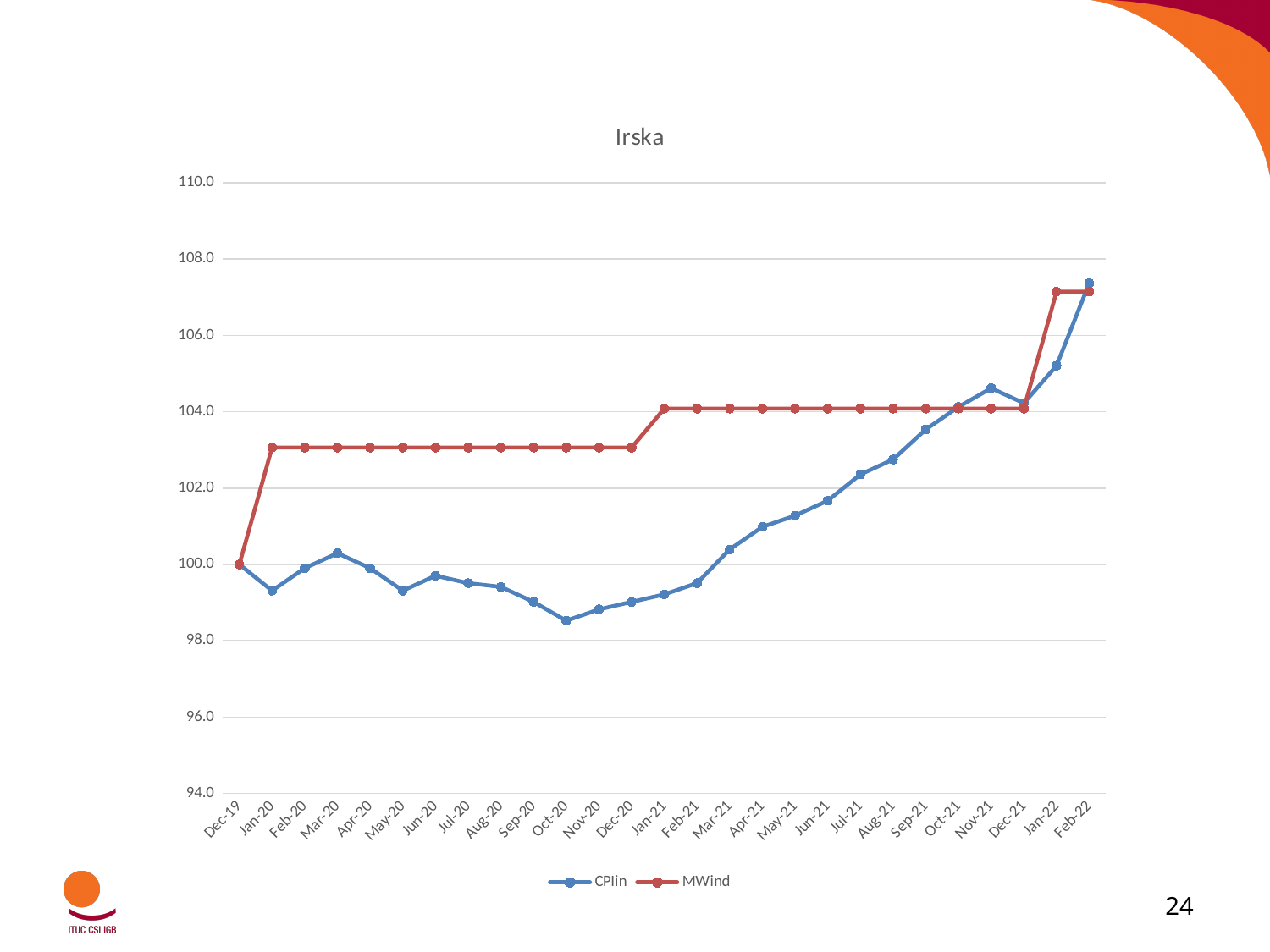
Is the value for CPlin in Aug-21 greater or less than 104.0? less Is the value for MWind in Feb-20 greater or less than 102.0? greater In Jun-20, which series has the higher value, CPlin or MWind? MWind Is the value for CPlin in Oct-20 greater or less than 100.0? less How many series does the legend list? 2 In which month does the CPlin series reach its highest value? Feb-22 How many points are plotted along the x axis for each series? 27 Does the CPlin series rise or fall between Feb-21 and Feb-22? rise What kind of chart is shown on the slide? line chart What is the title of the chart? Irska What is the value for MWind in Dec-19? 100.0 In which month does the CPlin series reach its lowest value? Oct-20